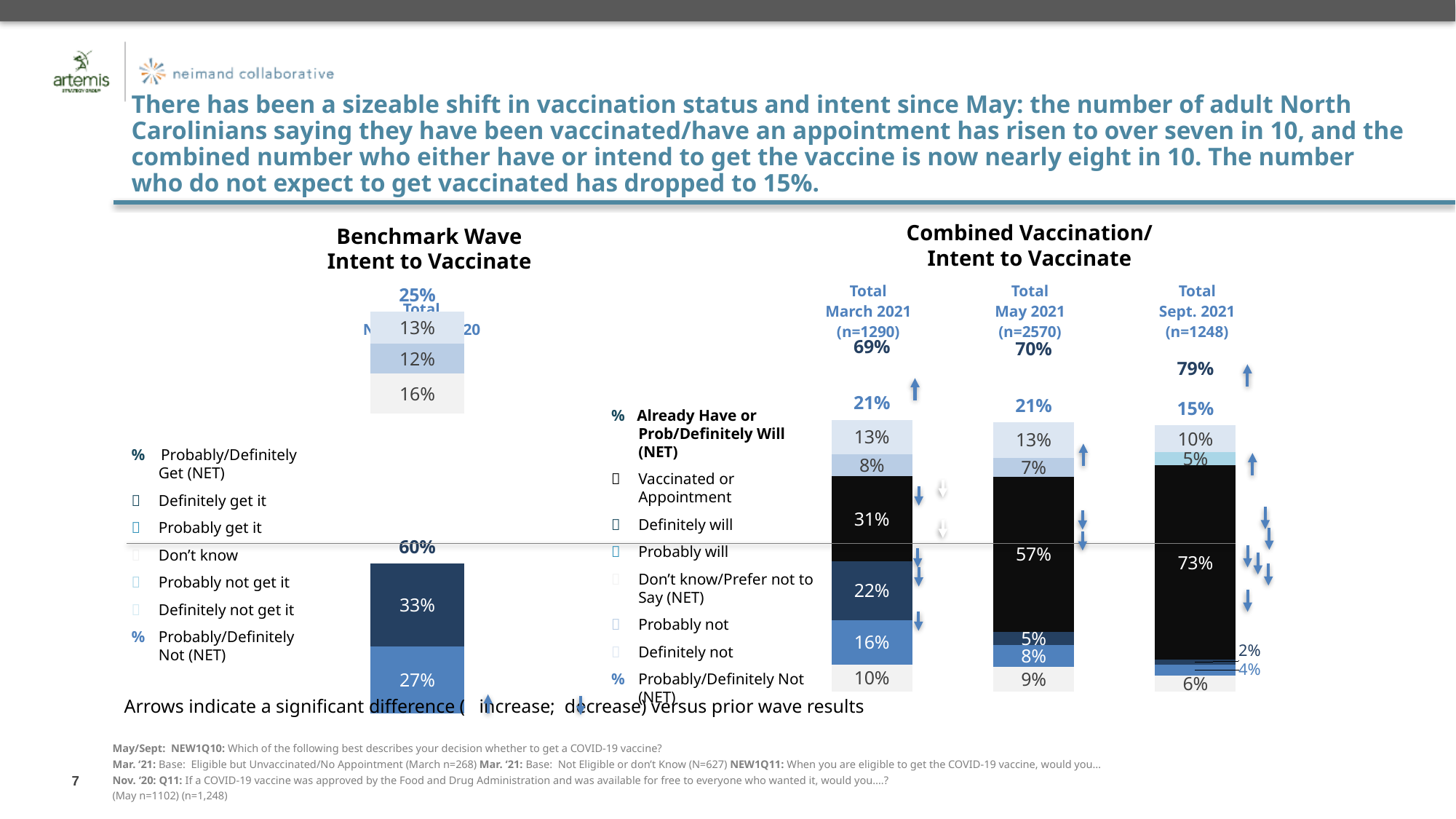
In the Combined Vaccination/Intent to Vaccinate chart, which wave has the highest Already Have or Prob/Definitely Will (NET) value? Total Sept. 2021 In the Combined Vaccination/Intent to Vaccinate chart, what is the Already Have or Prob/Definitely Will (NET) value for Total March 2021? 69% What kind of chart is the Combined Vaccination/Intent to Vaccinate chart? Stacked bar chart In the Combined Vaccination/Intent to Vaccinate chart, which wave has the lowest Vaccinated or Appointment value? Total March 2021 In the Combined Vaccination/Intent to Vaccinate chart, what percentage of the Total Sept. 2021 column is Vaccinated or Appointment? 73% In the Combined Vaccination/Intent to Vaccinate chart, what is the Vaccinated or Appointment value for Total May 2021? 57% In the Combined Vaccination/Intent to Vaccinate chart, what is the Probably/Definitely Not (NET) value for Total Sept. 2021? 15% In the Combined Vaccination/Intent to Vaccinate chart, how many waves (columns) are shown? 3 In the Benchmark Wave Intent to Vaccinate chart, what is the Probably/Definitely Get (NET) value? 60% In the Combined Vaccination/Intent to Vaccinate chart, is the Don't know/Prefer not to Say value larger for Total March 2021 or Total Sept. 2021? Total March 2021 In the Combined Vaccination/Intent to Vaccinate chart, what is the difference between the Vaccinated or Appointment values for Total Sept. 2021 and Total March 2021? 42 percentage points In the Benchmark Wave Intent to Vaccinate chart, what is the Definitely get it value? 33%